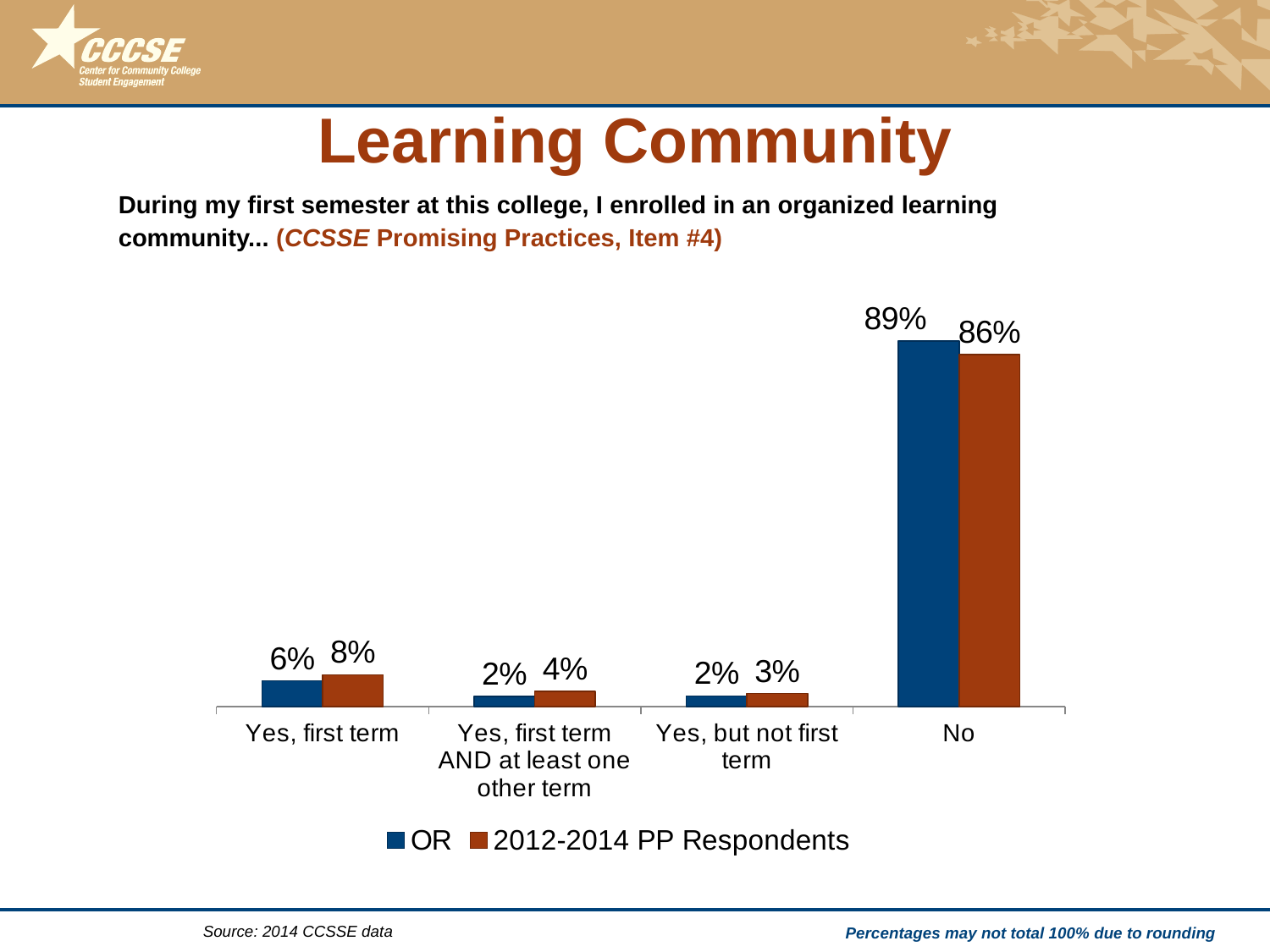
How many categories are shown on the x axis? 4 Which category has the highest value for the OR series? No What kind of chart is shown on the slide? Bar chart For "Yes, first term", which series has the larger value, OR or 2012-2014 PP Respondents? 2012-2014 PP Respondents What is the 2012-2014 PP Respondents value for "Yes, but not first term"? 3% What is the OR value for "No"? 89% What is the OR value for "Yes, first term AND at least one other term"? 2% How many series does the legend list? 2 What is the difference between the OR and 2012-2014 PP Respondents values for "No"? 3% What is the difference between the 2012-2014 PP Respondents and OR values for "Yes, first term"? 2% What is the 2012-2014 PP Respondents value for "Yes, first term"? 8% For "No", which series has the larger value, OR or 2012-2014 PP Respondents? OR